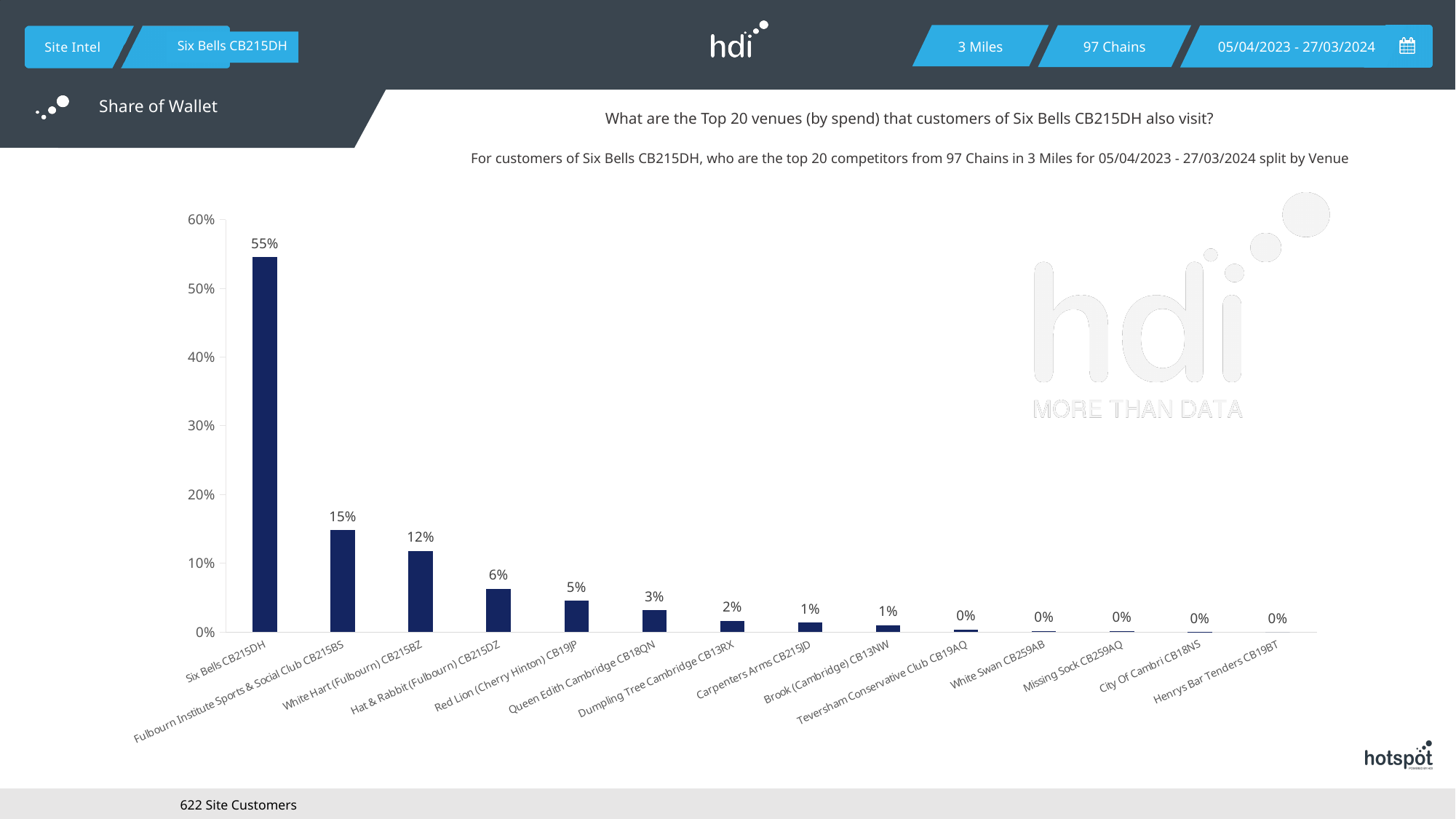
What is the difference between the values for Six Bells CB215DH and Fulbourn Institute Sports & Social Club CB215BS? 40% What is the value for Six Bells CB215DH? 55% Which venue has the highest value? Six Bells CB215DH Which is larger, the value for White Hart (Fulbourn) CB215BZ or Hat & Rabbit (Fulbourn) CB215DZ? White Hart (Fulbourn) CB215BZ What is the value for Red Lion (Cherry Hinton) CB19JP? 5% What is the value for Queen Edith Cambridge CB18QN? 3% What is the value for Fulbourn Institute Sports & Social Club CB215BS? 15% What kind of chart is shown on the slide? Bar chart How many venues are shown on the chart? 14 What is the value for Hat & Rabbit (Fulbourn) CB215DZ? 6% What is the value for White Hart (Fulbourn) CB215BZ? 12% Do the values rise or fall from left to right along the x axis? Fall